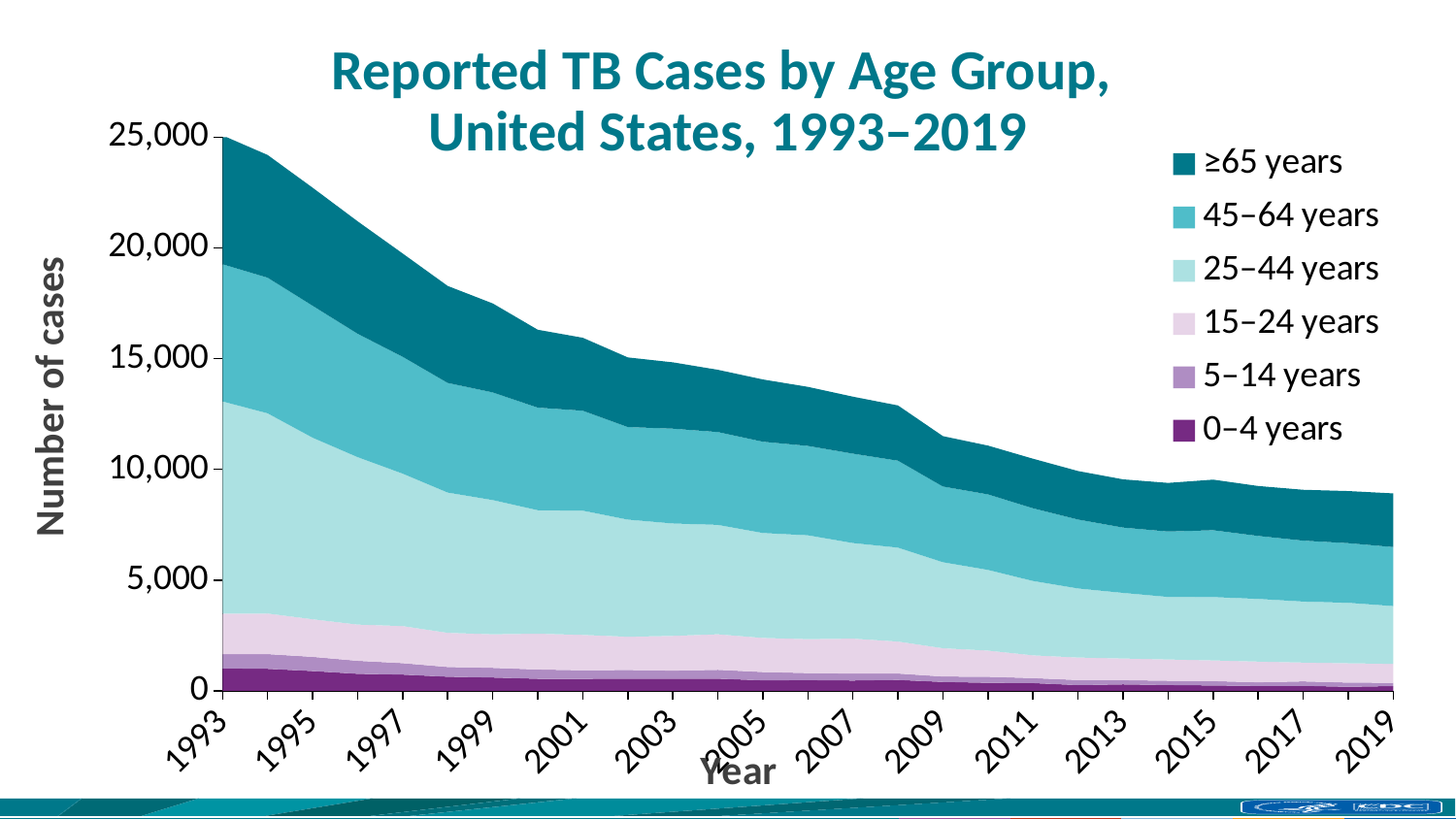
How many age groups does the legend list? 6 Do the total reported TB cases rise or fall from 1993 to 2019? fall Which year has the highest total number of reported TB cases? 1993 Which age group accounts for the largest band of cases in 1993? 25–44 years Is the total number of cases in 2009 greater or less than 15,000? less Which year has the larger total number of cases, 1995 or 2015? 1995 Is the total number of cases in 2019 greater or less than 10,000? less How many years are plotted along the x axis? 27 What kind of chart is shown on the slide? stacked area chart Is the total number of cases in 1999 greater or less than 15,000? greater What is the title of the chart? Reported TB Cases by Age Group, United States, 1993–2019